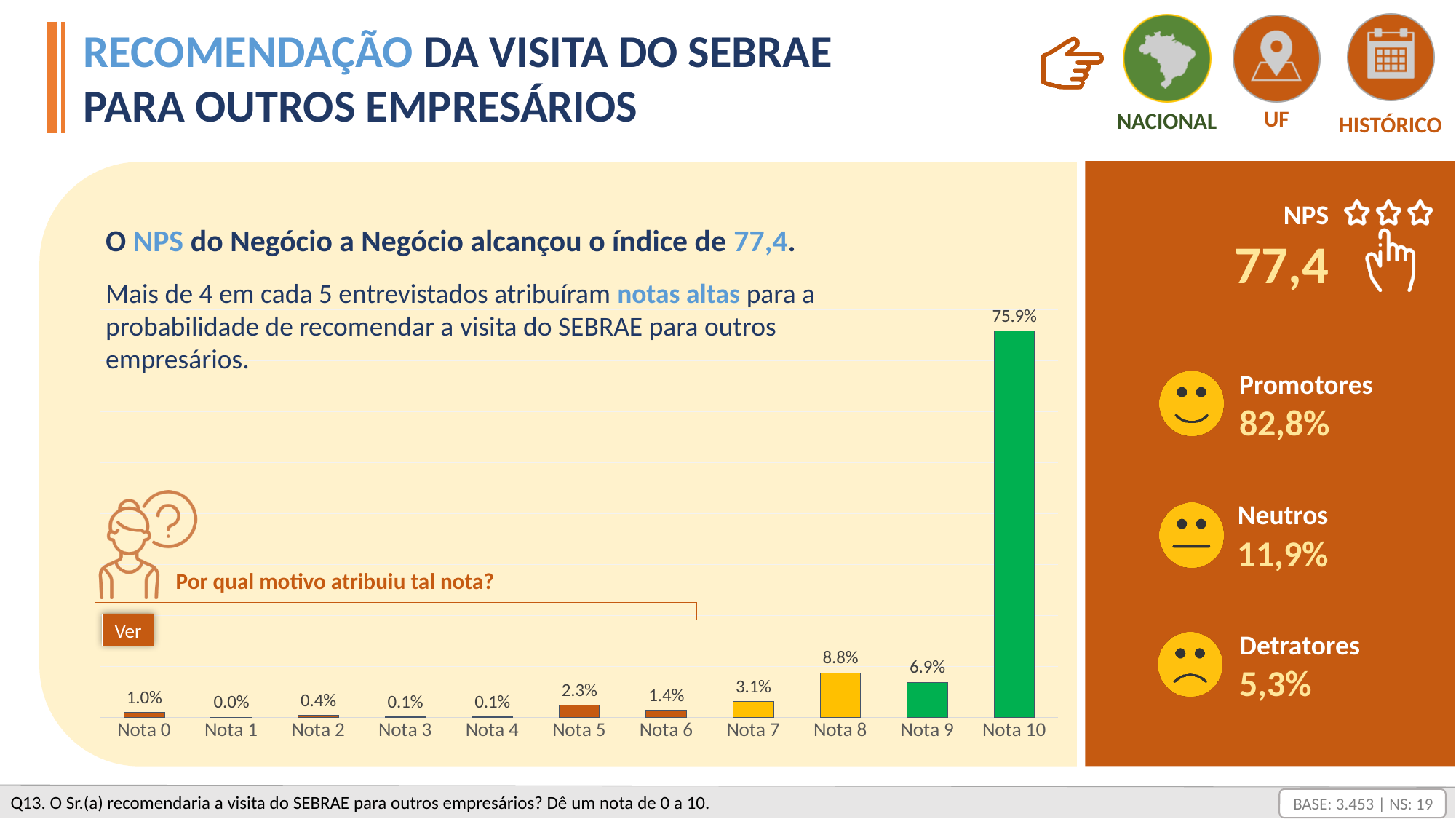
What is the value for Nota 1? 0.0% What is the value for Nota 8? 8.8% Which category has the lowest value? Nota 1 Which is larger, the value for Nota 7 or the value for Nota 6? Nota 7 What is the difference between the values for Nota 8 and Nota 9? 1.9% What kind of chart is shown on the slide? Bar chart What is the value for Nota 10? 75.9% How many categories are shown on the x axis? 11 What colour are the bars for Nota 9 and Nota 10? Green What is the difference between the values for Nota 10 and Nota 8? 67.1% What is the value for Nota 5? 2.3% Which category has the highest value? Nota 10